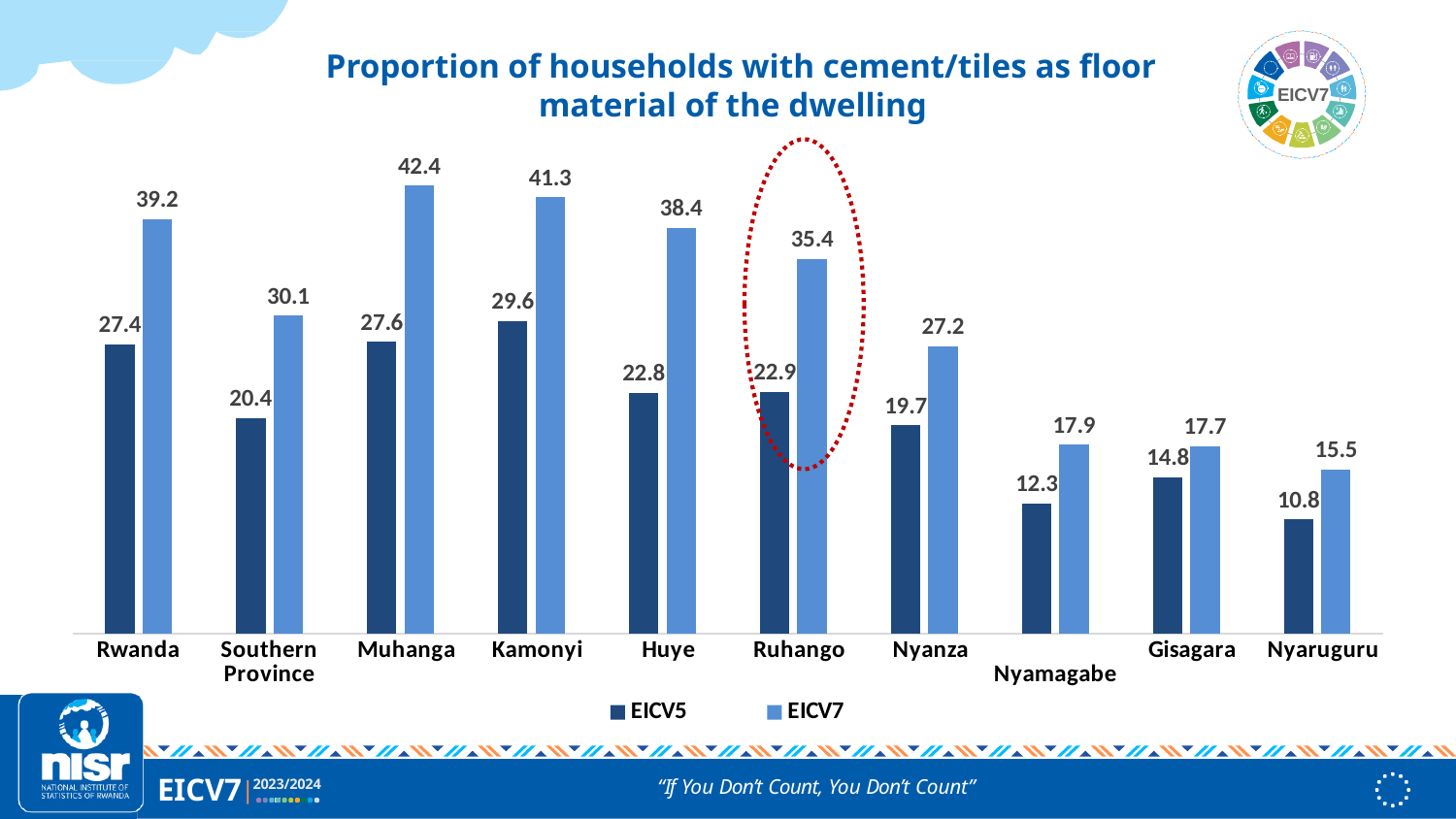
What is the EICV7 value for Ruhango? 35.4 Which is larger, the EICV7 value for Huye or the EICV7 value for Nyanza? Huye Which category has the highest EICV7 value? Muhanga What is the title of the chart? Proportion of households with cement/tiles as floor material of the dwelling Which category has the lowest EICV5 value? Nyaruguru What is the difference between the EICV7 and EICV5 values for Ruhango? 12.5 What is the difference between the EICV7 and EICV5 values for Rwanda? 11.8 How many series does the legend list? 2 What kind of chart is shown on the slide? Bar chart What is the EICV5 value for Kamonyi? 29.6 What is the EICV7 value for Southern Province? 30.1 How many categories are shown on the x axis? 10